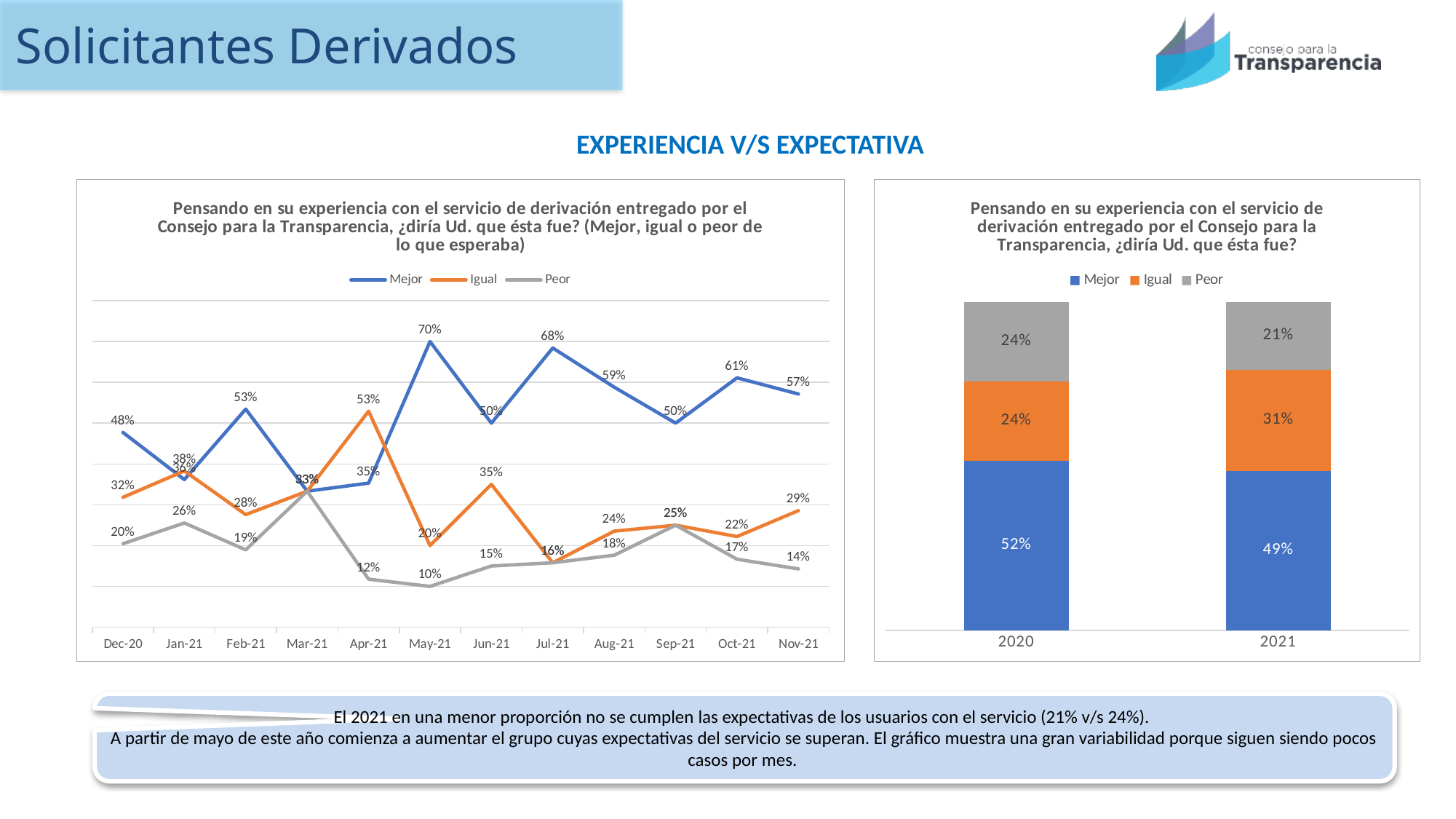
In the line chart on the left, in which month is the Peor series lowest? May-21 In the line chart on the left, how many months are shown on the x axis? 12 In the stacked bar chart on the right, what is the value for Mejor in 2021? 49% In the stacked bar chart on the right, which year has the larger Igual value, 2020 or 2021? 2021 In the line chart on the left, what is the difference between the Mejor and Peor values in Nov-21? 43% In the line chart on the left, what is the Igual value for Apr-21? 53% In the line chart on the left, what is the Mejor value for May-21? 70% In the stacked bar chart on the right, what is the value for Igual in 2020? 24% In the stacked bar chart on the right, how many series does the legend list? 3 What kind of chart is the chart on the right of the slide? Stacked bar chart In the line chart on the left, in which month is the Mejor series highest? May-21 In the stacked bar chart on the right, what is the difference between the Peor values for 2020 and 2021? 3%